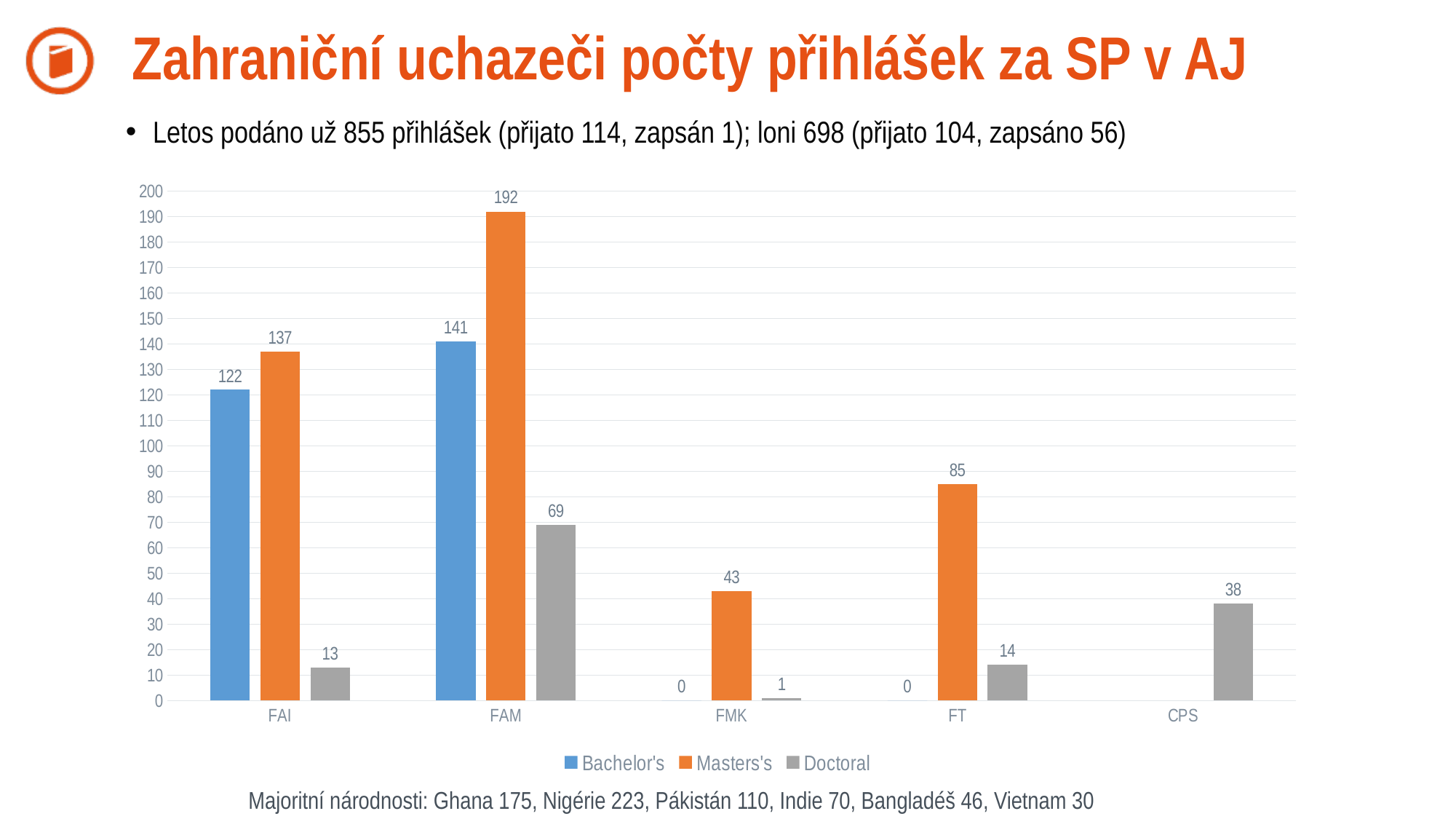
Which is larger, the Doctoral value for FAM or the Doctoral value for CPS? FAM What is the Doctoral value for CPS? 38 What is the Bachelor's value for FAI? 122 What is the Masters's value for FAM? 192 Which category has the highest Masters's value? FAM What is the difference between the Masters's and Bachelor's values for FAM? 51 How many categories are shown on the x axis? 5 What is the total of the three series for FT? 99 Is the Masters's value for FT greater or less than 100? less What kind of chart is shown on the slide? bar chart How many series does the legend list? 3 Which category has the lowest Doctoral value? FMK